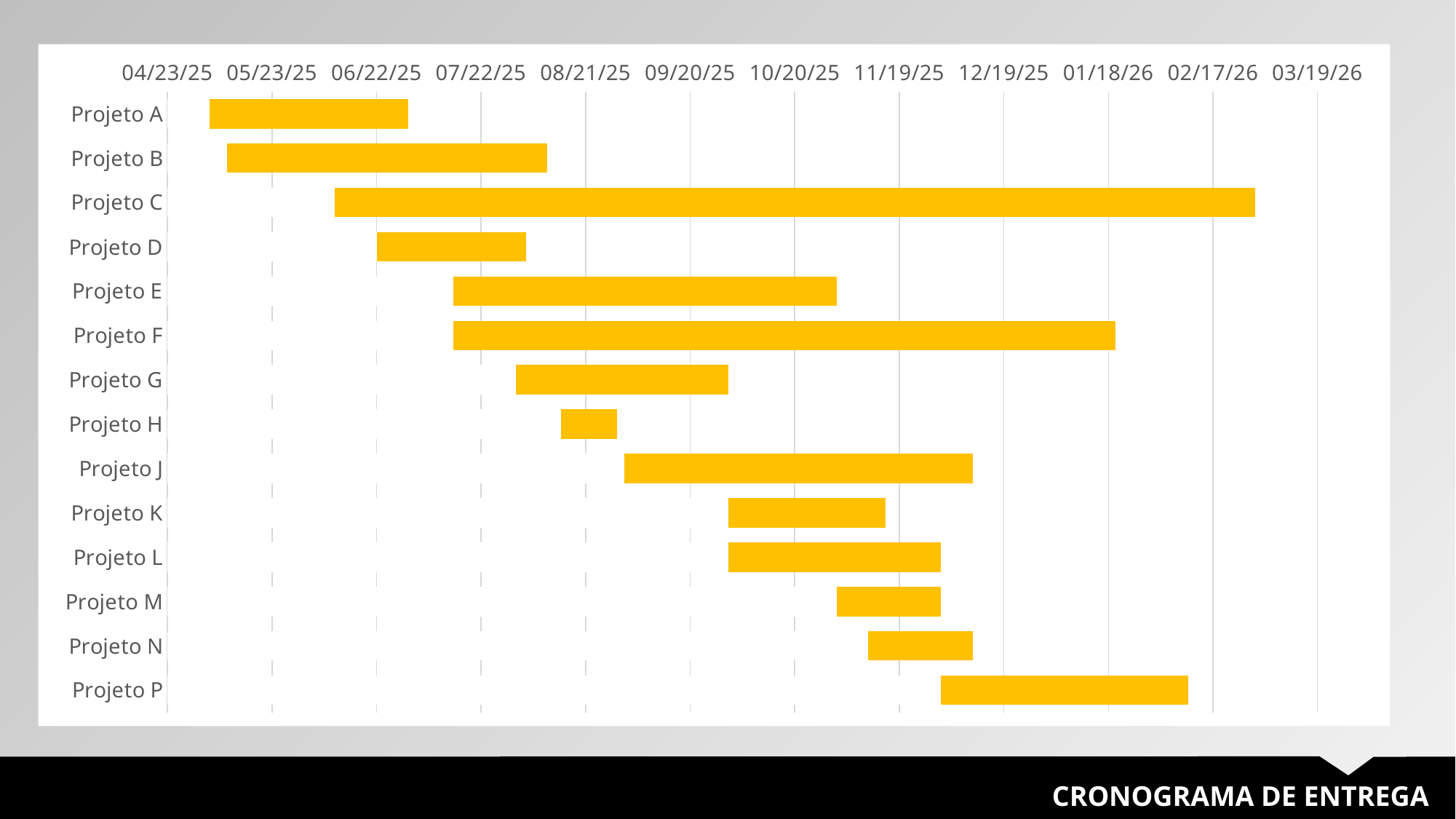
Which project starts earliest on the timeline? Projeto A Which project has the longest bar on the chart? Projeto C Does Projeto H start before or after 08/21/25? before What kind of chart is shown on the slide? Bar chart (Gantt chart) Which project starts latest on the timeline? Projeto P Which bar is longer, Projeto J or Projeto K? Projeto J What is the title shown at the bottom of the slide? CRONOGRAMA DE ENTREGA Which project has the shortest bar on the chart? Projeto H How many projects are listed on the chart? 14 Does Projeto F end before or after 12/19/25? after Does Projeto C end before or after 02/17/26? after Which bar is longer, Projeto F or Projeto D? Projeto F